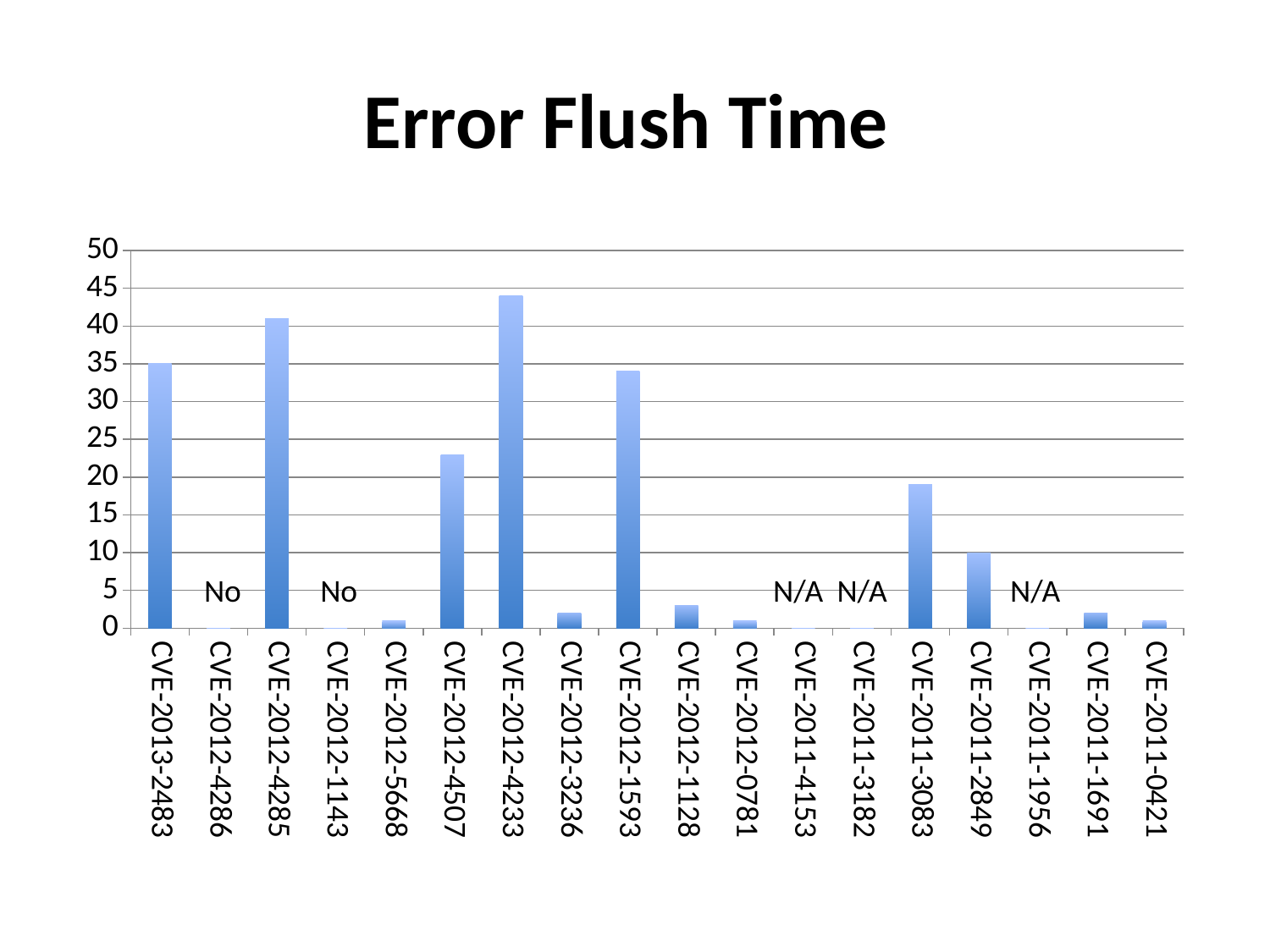
What type of chart is shown on the slide? bar chart What label is shown in place of a bar for CVE-2011-4153? N/A What is the title of the chart? Error Flush Time Is the value for CVE-2012-4507 greater or less than 25? less Is the value for CVE-2011-3083 greater or less than 15? greater Which is larger, the value for CVE-2012-1593 or the value for CVE-2012-4507? CVE-2012-1593 What is the value for CVE-2013-2483? 35 How many CVE categories are shown on the x axis? 18 Which is larger, the value for CVE-2012-4285 or the value for CVE-2013-2483? CVE-2012-4285 Which CVE has the highest error flush time? CVE-2012-4233 What is the value for CVE-2011-2849? 10 Is the value for CVE-2012-4285 greater or less than 40? greater